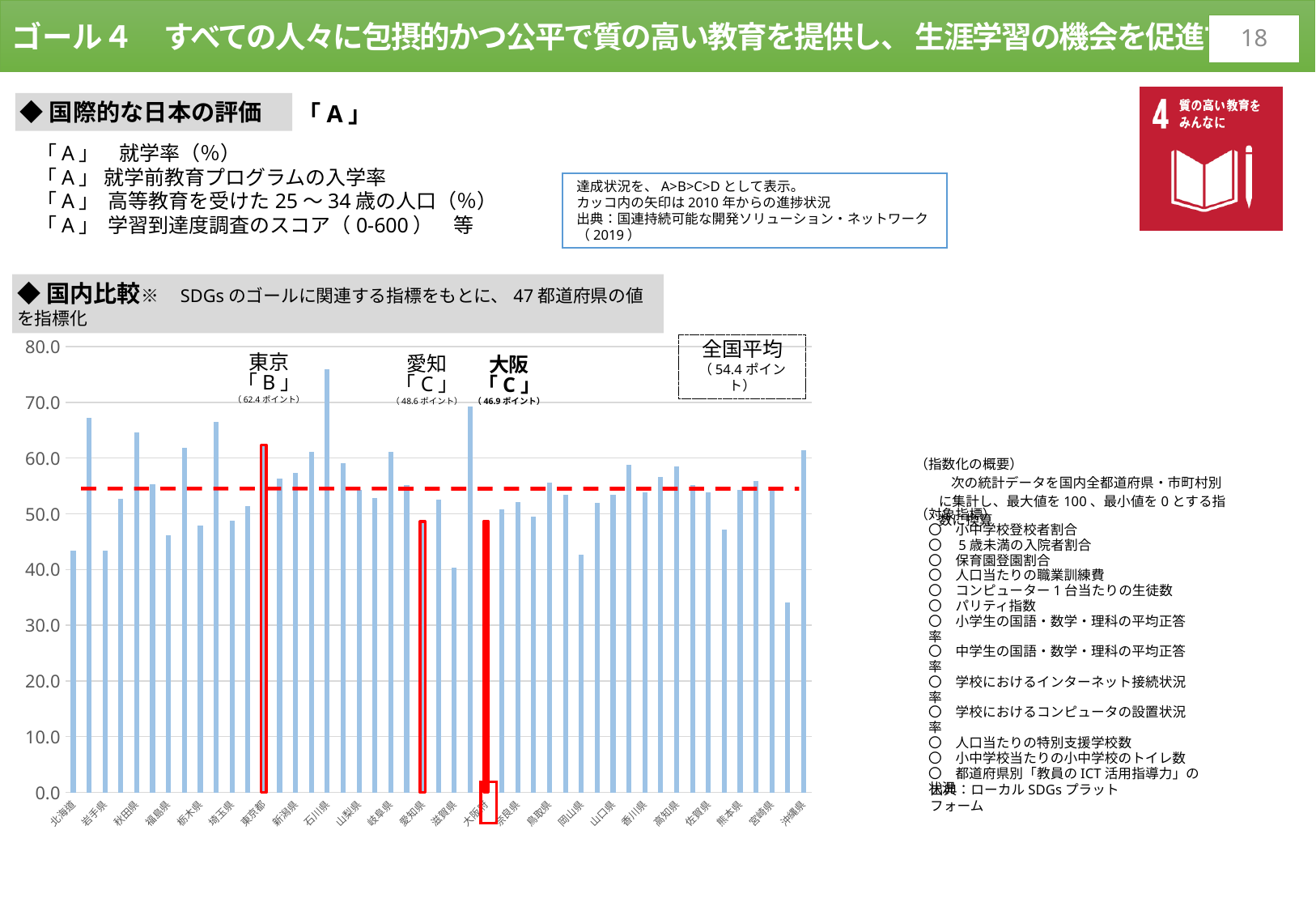
What kind of chart is used for the 国内比較 section? bar chart In the 国内比較 bar chart, is the value for 大阪 greater or less than 50.0? less What is the difference between the values for 東京 and 大阪 in the 国内比較 bar chart? 15.5 ポイント What is the difference between the value for 東京 and the 全国平均 in the 国内比較 bar chart? 8.0 ポイント What grade is shown for 東京 on the 国内比較 bar chart? B In the 国内比較 bar chart, which has the larger value, 愛知 or 大阪? 愛知 What is the value for 東京 in the 国内比較 bar chart? 62.4 ポイント How many prefectures are compared in the 国内比較 bar chart? 47 What is the value for 愛知 in the 国内比較 bar chart? 48.6 ポイント In the 国内比較 bar chart, is the value for 東京 greater or less than 60.0? greater What is the 全国平均 value shown on the 国内比較 bar chart? 54.4 ポイント What is the value for 大阪 in the 国内比較 bar chart? 46.9 ポイント